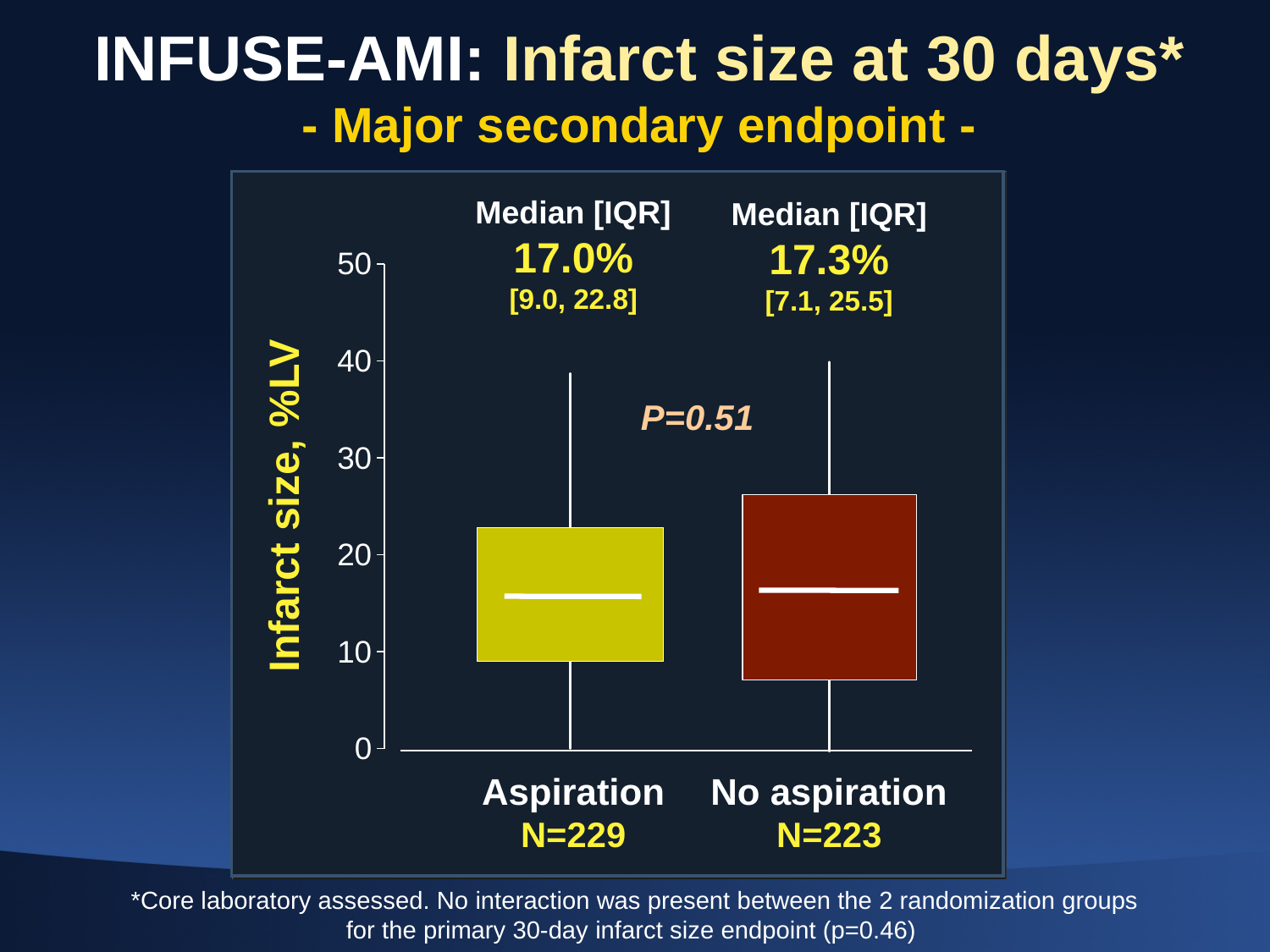
What is the median infarct size for the No aspiration group? 17.3% What is the label of the y axis? Infarct size, %LV How many patients are in the No aspiration group? N=223 What is the interquartile range shown for the No aspiration group? [7.1, 25.5] What is the median infarct size for the Aspiration group? 17.0% What P value is shown on the chart? P=0.51 What is the interquartile range shown for the Aspiration group? [9.0, 22.8] What is the difference between the median infarct sizes of the No aspiration and Aspiration groups? 0.3% Which group has the higher median infarct size, Aspiration or No aspiration? No aspiration How many groups are plotted on the chart? 2 How many patients are in the Aspiration group? N=229 What kind of chart is shown on the slide? Box plot